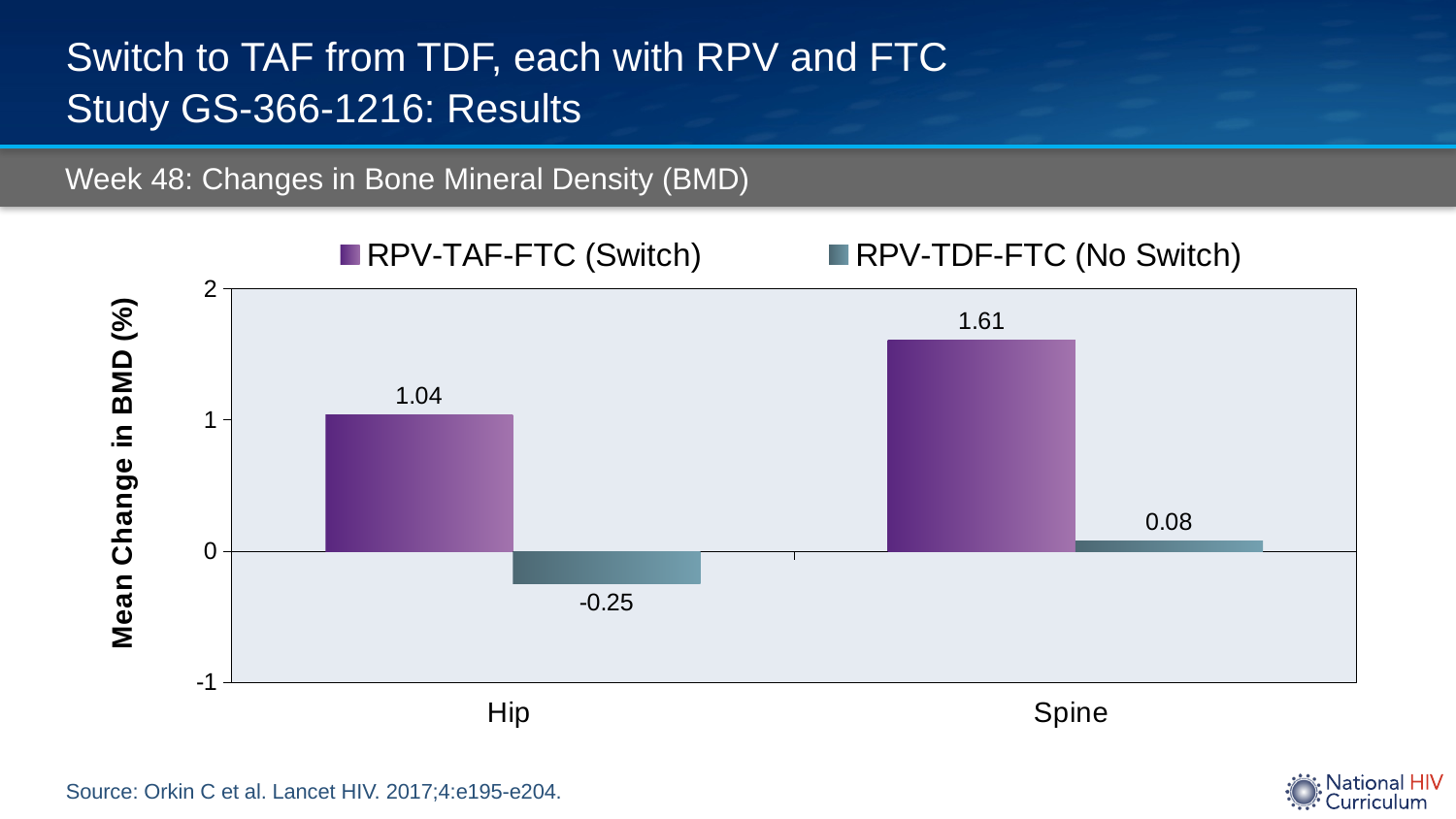
What kind of chart is shown on the slide? Bar chart How many series does the legend list? 2 What is the mean change in BMD for RPV-TAF-FTC (Switch) at the Hip? 1.04 What is the mean change in BMD for RPV-TAF-FTC (Switch) at the Spine? 1.61 Which is larger for RPV-TAF-FTC (Switch): the Hip value or the Spine value? Spine Which bar shows the lowest mean change in BMD? RPV-TDF-FTC (No Switch) at the Hip What is the difference between the Switch and No Switch values at the Spine? 1.53 What is the mean change in BMD for RPV-TDF-FTC (No Switch) at the Hip? -0.25 Which bar shows the highest mean change in BMD? RPV-TAF-FTC (Switch) at the Spine What is the difference between the Switch and No Switch values at the Hip? 1.29 How many categories are shown on the x axis? 2 What is the mean change in BMD for RPV-TDF-FTC (No Switch) at the Spine? 0.08